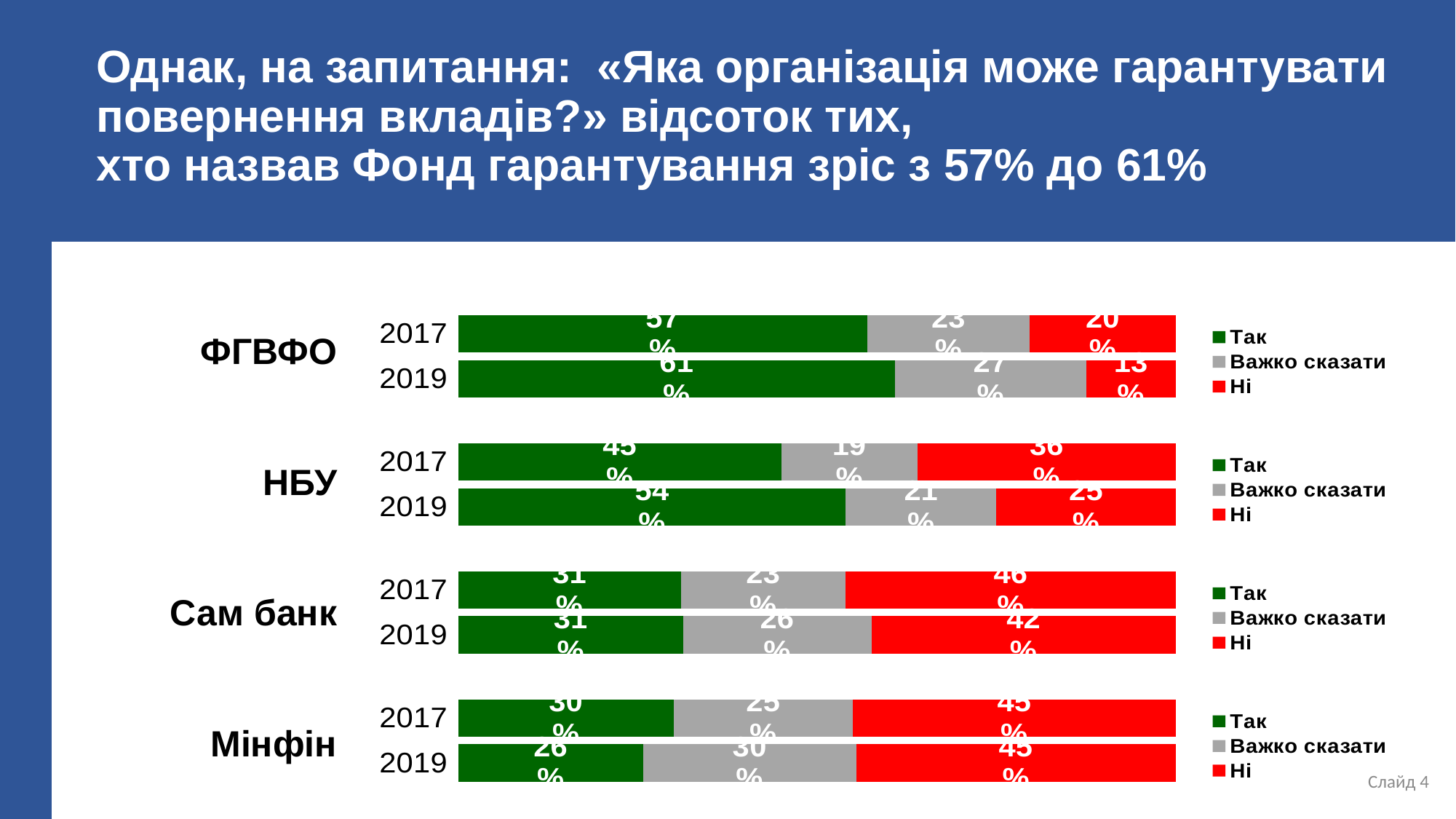
In the НБУ chart, by how much did the Так value change from 2017 to 2019? 9% In the Мінфін chart, what is the value of Так for 2019? 26% In the Мінфін chart, did the Так value rise or fall from 2017 to 2019? fall In the Сам банк chart, which series has the highest value in 2019? Ні Which colour represents Важко сказати in the legends? grey In the ФГВФО chart, which is larger: Ні in 2017 or Ні in 2019? Ні in 2017 In the НБУ chart, what is the value of Важко сказати for 2019? 21% In the ФГВФО chart, what is the value of Так for 2019? 61% In the Сам банк chart, what is the value of Ні for 2017? 46% How many series does the legend of the НБУ chart list? 3 In the ФГВФО chart, what is the value of Ні for 2017? 20% What kind of chart is used for Сам банк? stacked bar chart